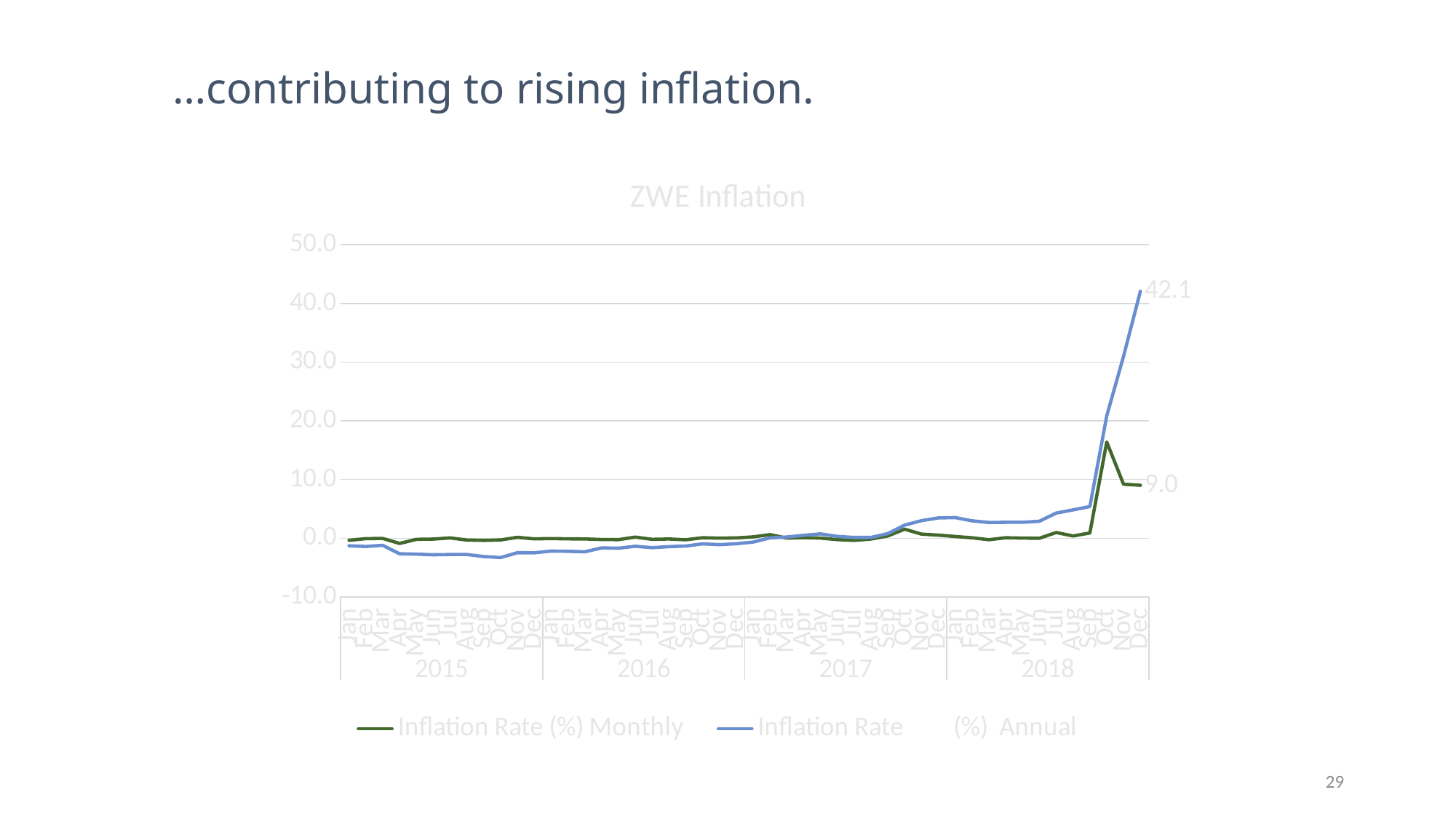
Is the annual inflation rate in Oct 2015 greater or less than 0? less What kind of chart is shown on the slide? line chart In which month and year does the annual inflation rate reach its highest value? Dec 2018 Is the monthly inflation rate at its Oct 2018 peak greater or less than 10? greater What is the annual inflation rate value labelled at Dec 2018? 42.1 What is the monthly inflation rate value labelled at Dec 2018? 9.0 Does the annual inflation rate rise or fall over the course of 2018? rise Is the annual inflation rate at Dec 2018 greater or less than 40? greater What is the title of the chart? ZWE Inflation How many series does the legend of the ZWE Inflation chart list? 2 At Dec 2018, which series has the larger value, Inflation Rate (%) Monthly or Inflation Rate (%) Annual? Inflation Rate (%) Annual What is the difference between the annual (42.1) and monthly (9.0) inflation rate values labelled at Dec 2018? 33.1